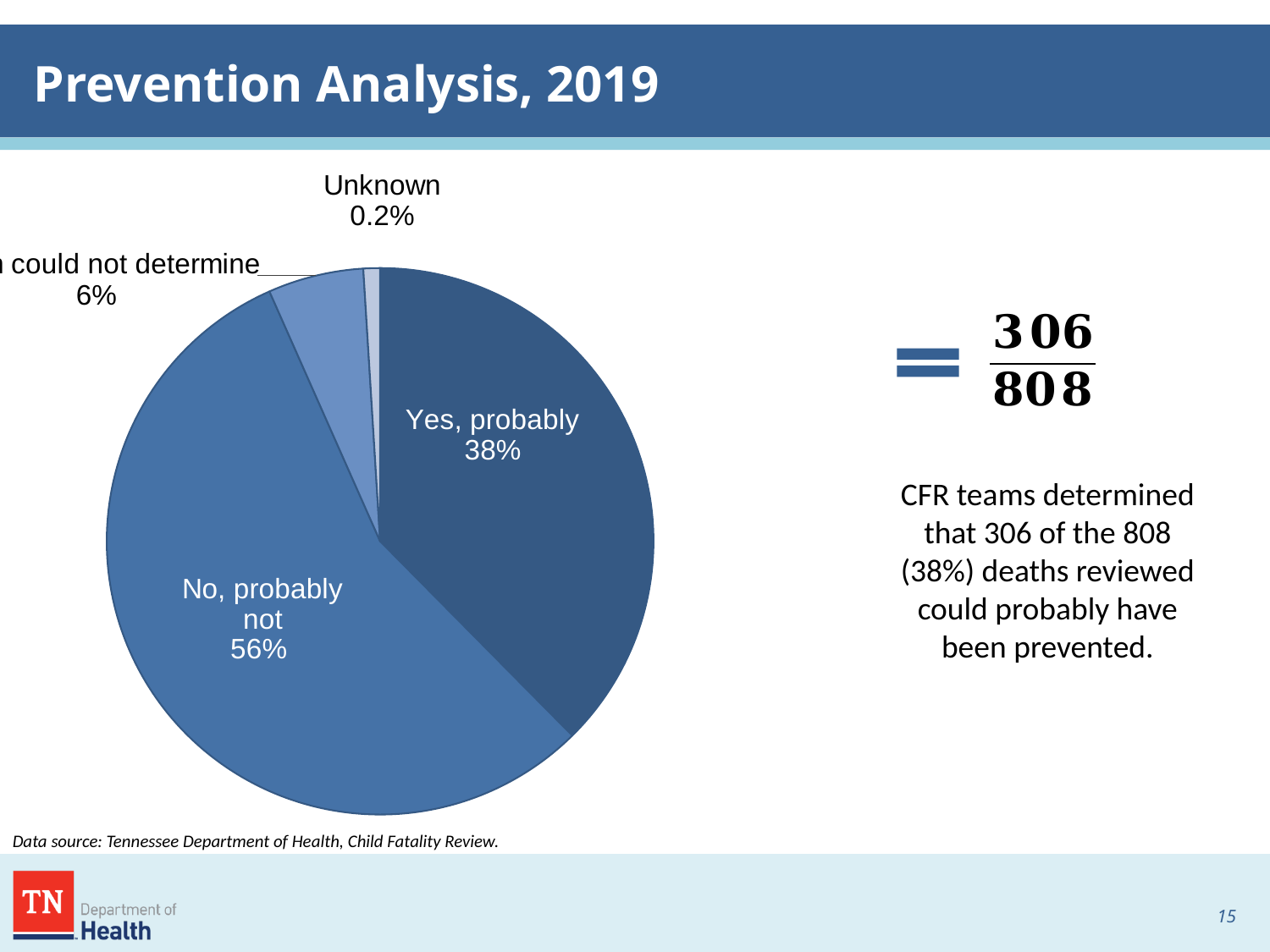
What share of the pie is labelled "Yes, probably"? 38% What is the title of the slide containing the pie chart? Prevention Analysis, 2019 What percentage is shown for the "could not determine" slice? 6% What share of the pie is labelled "Unknown"? 0.2% How many slices does the pie chart have? 4 Which slice of the pie is the smallest? Unknown According to the text beside the chart, how many of the 808 deaths reviewed could probably have been prevented? 306 Which is larger, the "Yes, probably" slice or the "could not determine" slice? Yes, probably What share of the pie is labelled "No, probably not"? 56% What is the difference in percentage points between "No, probably not" and "Yes, probably"? 18 What kind of chart is shown on the slide? pie chart Which slice of the pie is the largest? No, probably not